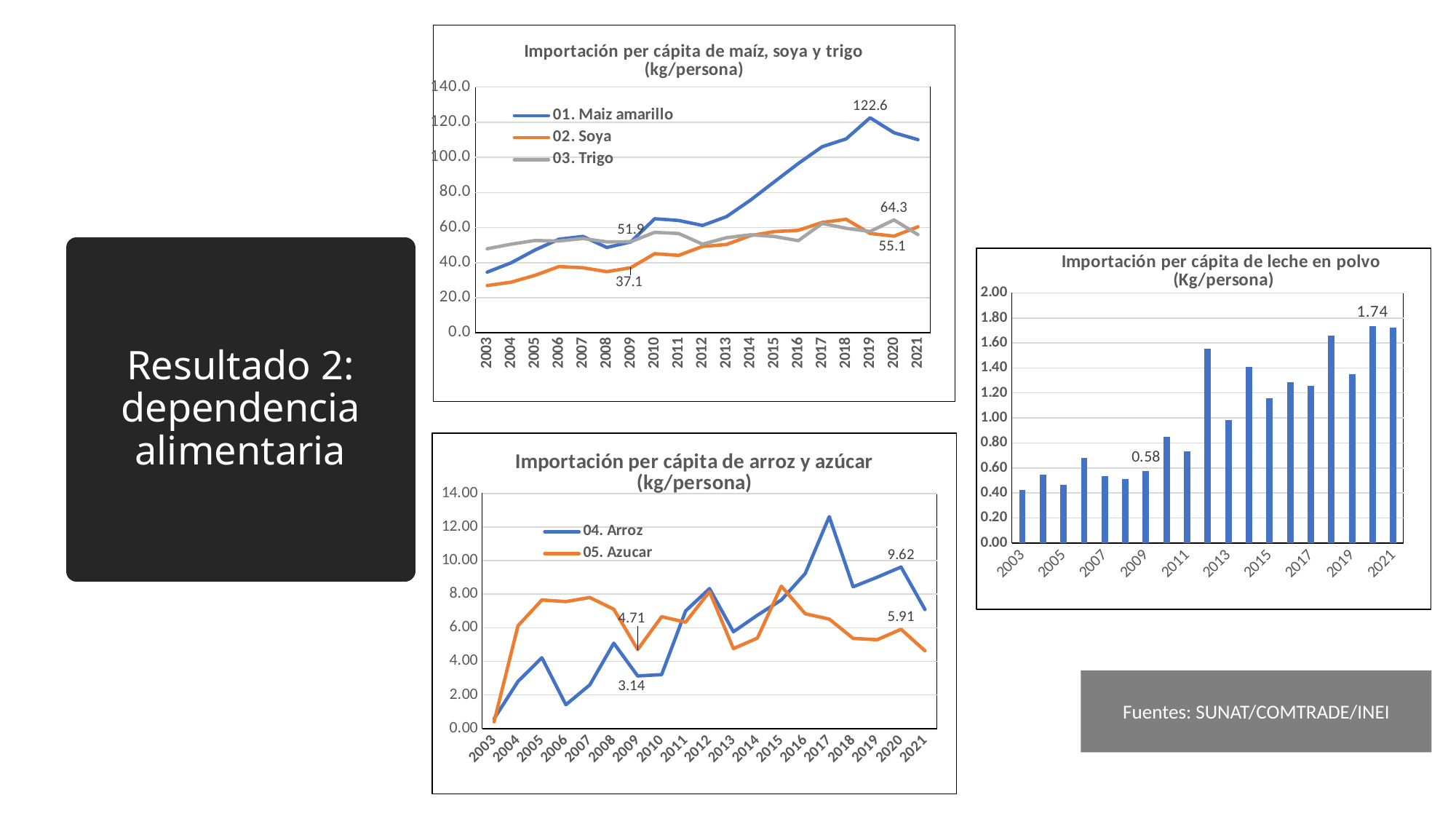
In the chart 'Importación per cápita de maíz, soya y trigo', what is the value for 01. Maiz amarillo in 2019? 122.6 In the chart 'Importación per cápita de maíz, soya y trigo', what is the value for 02. Soya in 2009? 37.1 In the chart 'Importación per cápita de arroz y azúcar', what is the difference between 04. Arroz and 05. Azucar in 2020? 3.71 In the chart 'Importación per cápita de maíz, soya y trigo', which series has the higher value in 2019, 01. Maiz amarillo or 03. Trigo? 01. Maiz amarillo In the chart 'Importación per cápita de leche en polvo', what kind of chart is used? bar chart In the chart 'Importación per cápita de maíz, soya y trigo', what is the difference between 03. Trigo and 02. Soya in 2020? 9.3 In the chart 'Importación per cápita de leche en polvo', how many years (bars) are shown? 19 In the chart 'Importación per cápita de arroz y azúcar', what is the value for 04. Arroz in 2020? 9.62 In the chart 'Importación per cápita de maíz, soya y trigo', how many series does the legend list? 3 In the chart 'Importación per cápita de arroz y azúcar', what is the value for 05. Azucar in 2009? 4.71 In the chart 'Importación per cápita de leche en polvo', what is the value for 2020? 1.74 In the chart 'Importación per cápita de maíz, soya y trigo', is the value for 01. Maiz amarillo in 2021 greater or less than 100.0? greater